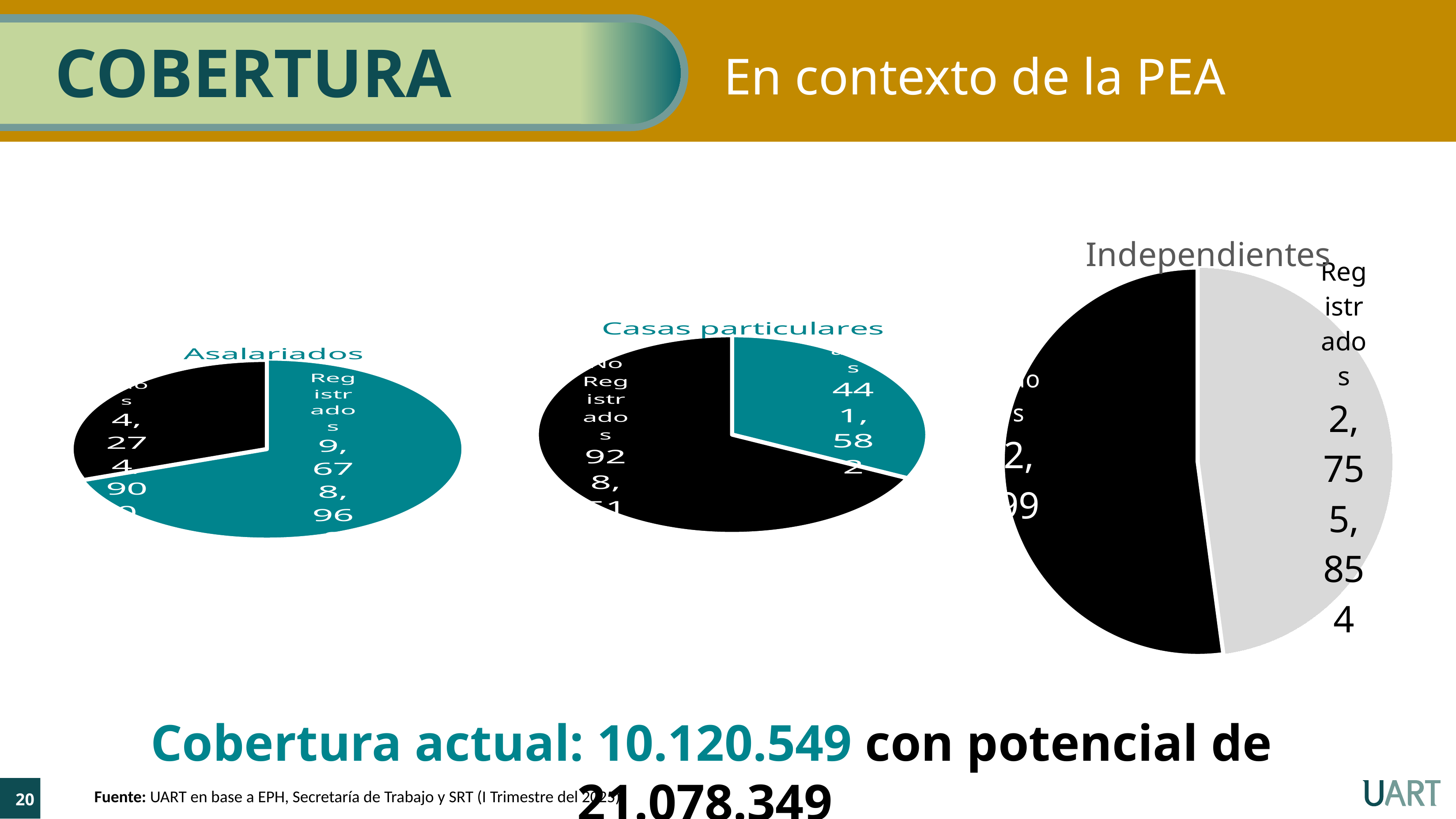
What is the title of the rightmost pie chart? Independientes How many pie charts are shown on the slide? 3 In the 'Asalariados' chart, which slice is larger, Registrados or No Registrados? Registrados In the 'Casas particulares' chart, which category has the smallest slice? Registrados In the 'Casas particulares' chart, what is the value for Registrados? 441,582 In the 'Casas particulares' chart, which slice is larger, Registrados or No Registrados? No Registrados In the 'Independientes' chart, what is the value for Registrados? 2,755,854 What kind of chart is the 'Asalariados' chart? pie chart How many slices does the 'Casas particulares' pie chart have? 2 What colour is the Registrados slice in the 'Casas particulares' chart? teal What kind of chart is the 'Independientes' chart? pie chart In the 'Asalariados' chart, which category has the largest slice? Registrados